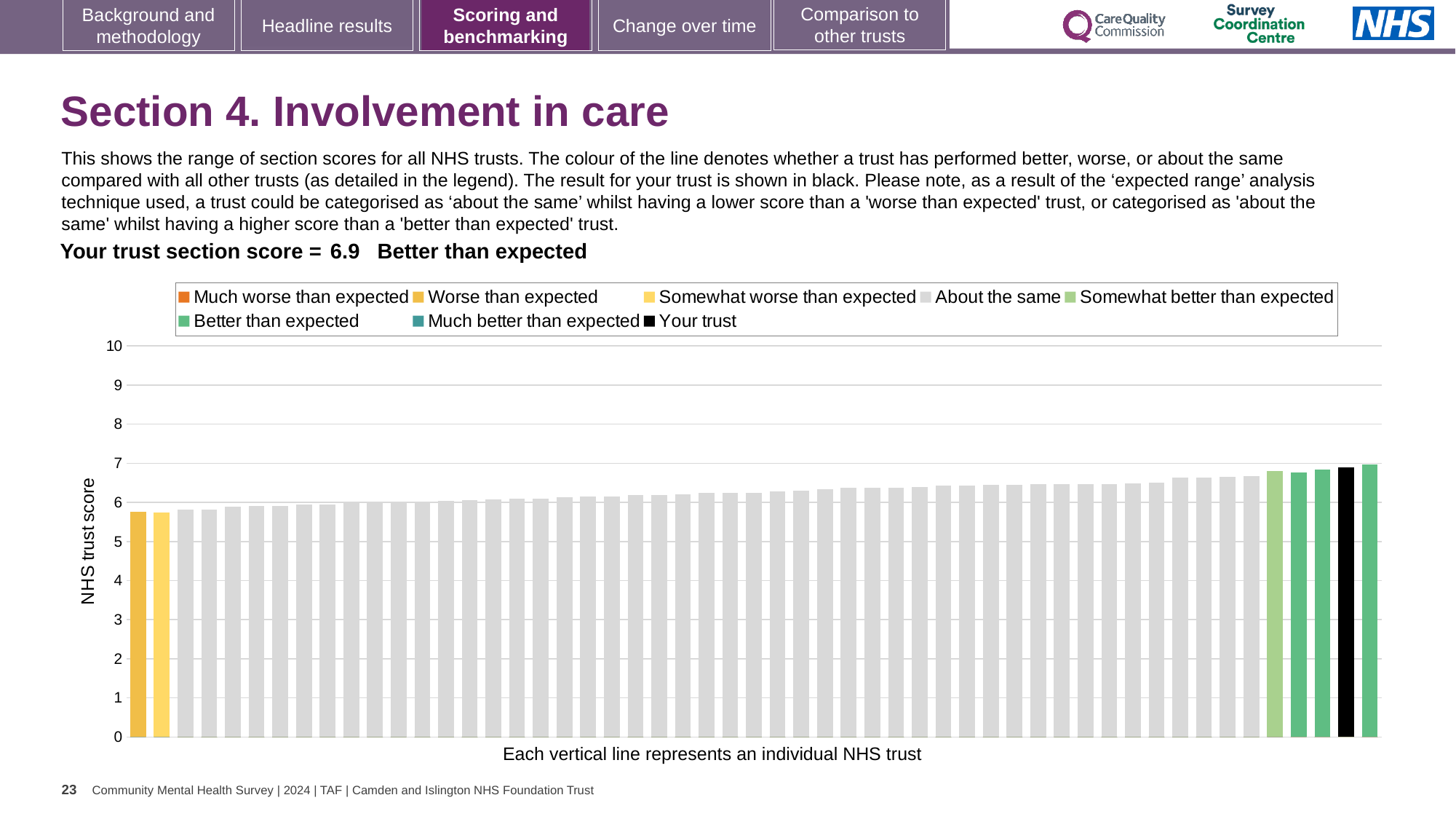
Is the value of the rightmost bar greater or less than 8? less What is the label on the vertical axis of the chart? NHS trust score Which is larger, the value of the black bar for your trust or the value of the leftmost bar? the black bar for your trust Do the bar values rise or fall from left to right along the x axis? rise Which performance category is your trust's section score given as? Better than expected What colour is the bar representing your trust? black Is the value of the leftmost bar greater or less than 6? less Is the value of the black bar for your trust greater or less than 6? greater How many entries does the chart legend list? 8 How many bars are to the right of the black bar for your trust? 1 What is the section score for your trust shown on the slide? 6.9 What kind of chart is shown on the slide? bar chart